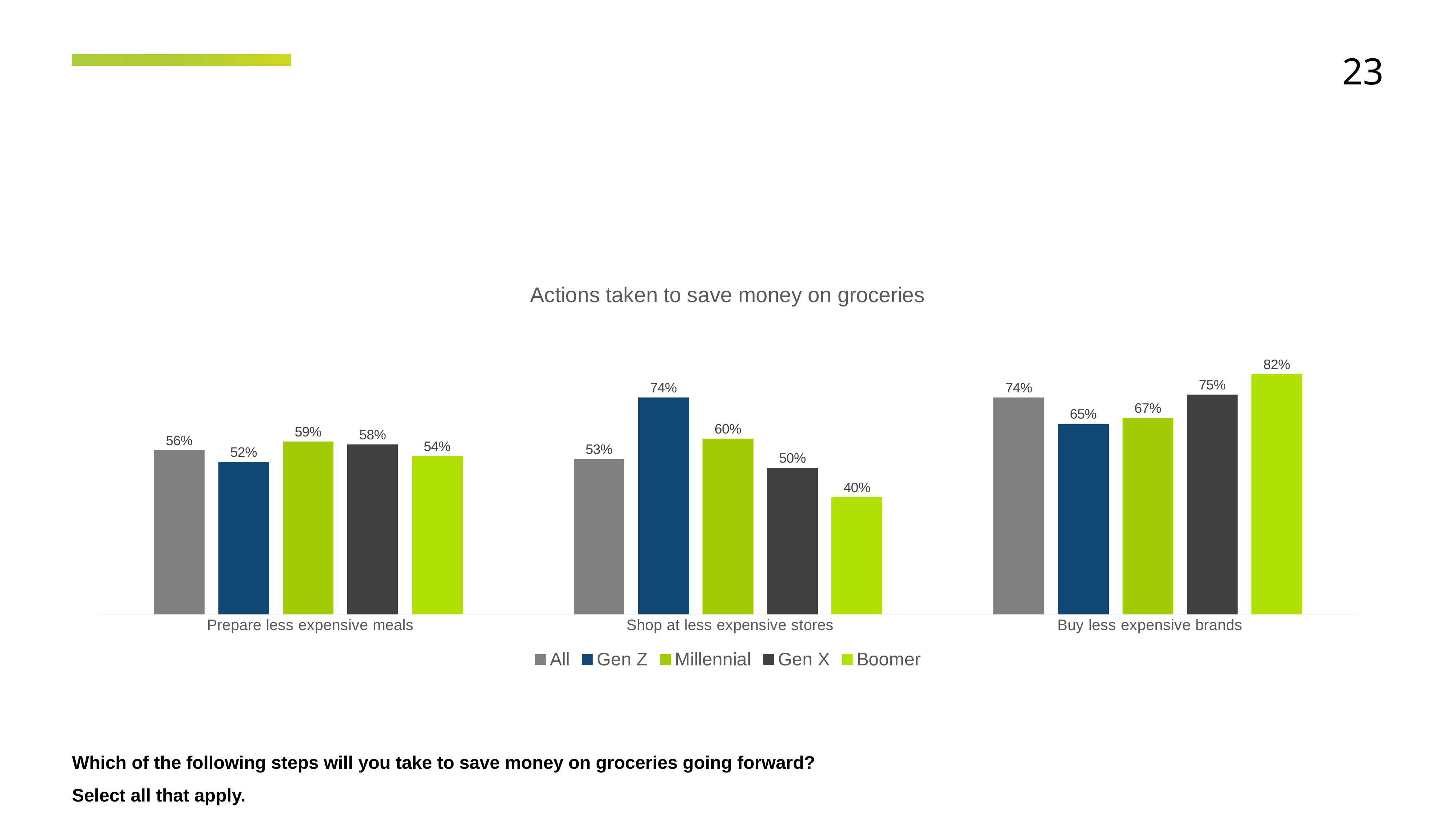
What is the value for Boomer in the 'Buy less expensive brands' category? 82% What is the difference between the Gen X and Millennial values in the 'Buy less expensive brands' category? 8% What is the title of the chart? Actions taken to save money on groceries Which series has the highest value in the 'Buy less expensive brands' category? Boomer Which series has the lowest value in the 'Shop at less expensive stores' category? Boomer Which is larger in the 'Prepare less expensive meals' category: Millennial or Gen Z? Millennial What is the value for Gen Z in the 'Shop at less expensive stores' category? 74% How many series does the legend list? 5 How many categories are shown on the x axis? 3 What kind of chart is shown on the slide? Bar chart What is the difference between the Gen Z and Boomer values in the 'Shop at less expensive stores' category? 34% What is the value for All in the 'Prepare less expensive meals' category? 56%